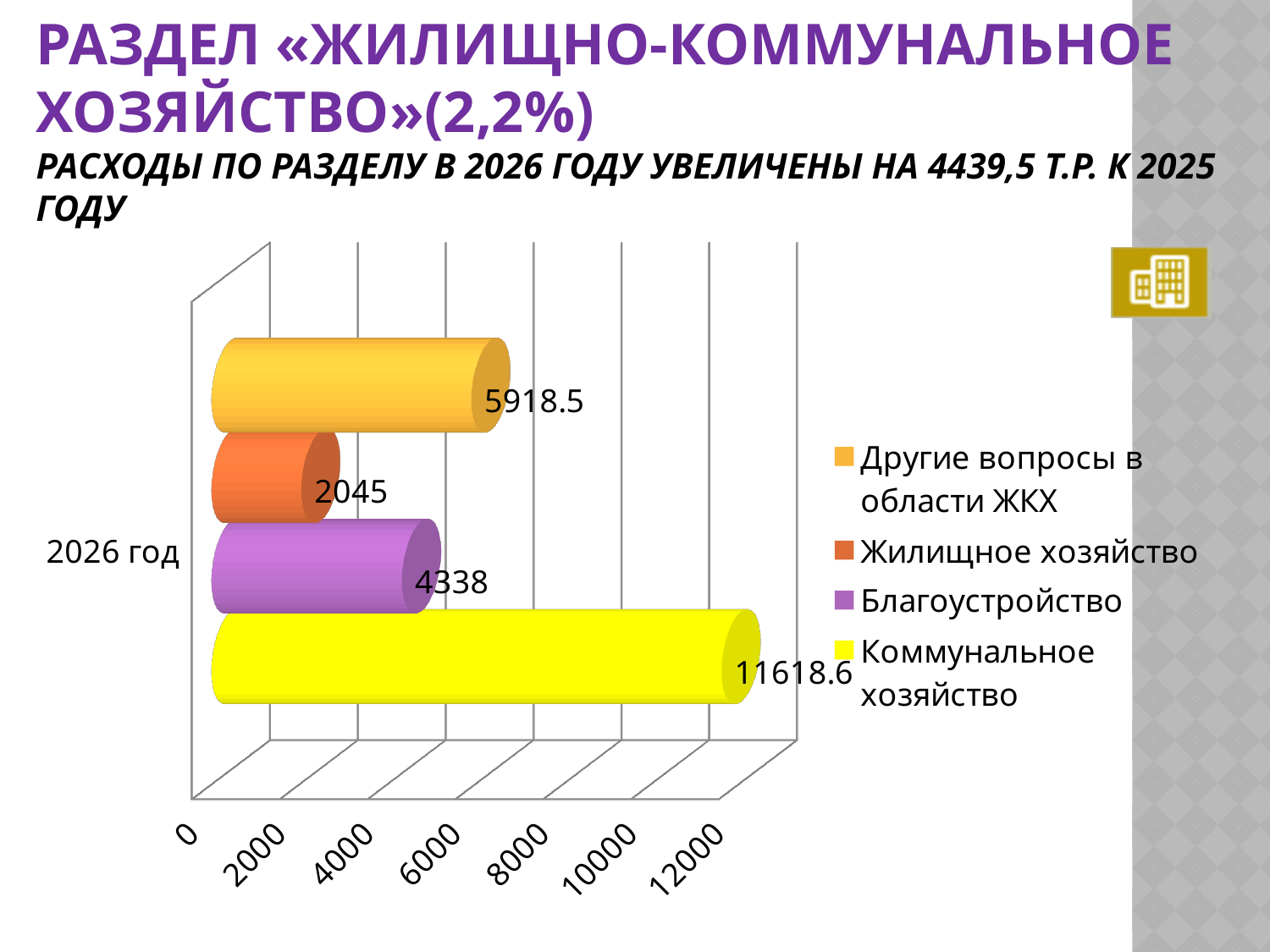
How many series does the legend list? 4 What is the difference between the values for Коммунальное хозяйство and Благоустройство? 7280.6 Which is larger, the value for Благоустройство or the value for Другие вопросы в области ЖКХ? Другие вопросы в области ЖКХ What is the value for Жилищное хозяйство in 2026 год? 2045 Which series has the highest value in 2026 год? Коммунальное хозяйство What is the value for Благоустройство in 2026 год? 4338 Is the value for Коммунальное хозяйство greater or less than 10000? greater What is the difference between the values for Другие вопросы в области ЖКХ and Жилищное хозяйство? 3873.5 Which series has the lowest value in 2026 год? Жилищное хозяйство What kind of chart is shown on the slide? bar chart What is the value for Другие вопросы в области ЖКХ in 2026 год? 5918.5 What is the value for Коммунальное хозяйство in 2026 год? 11618.6